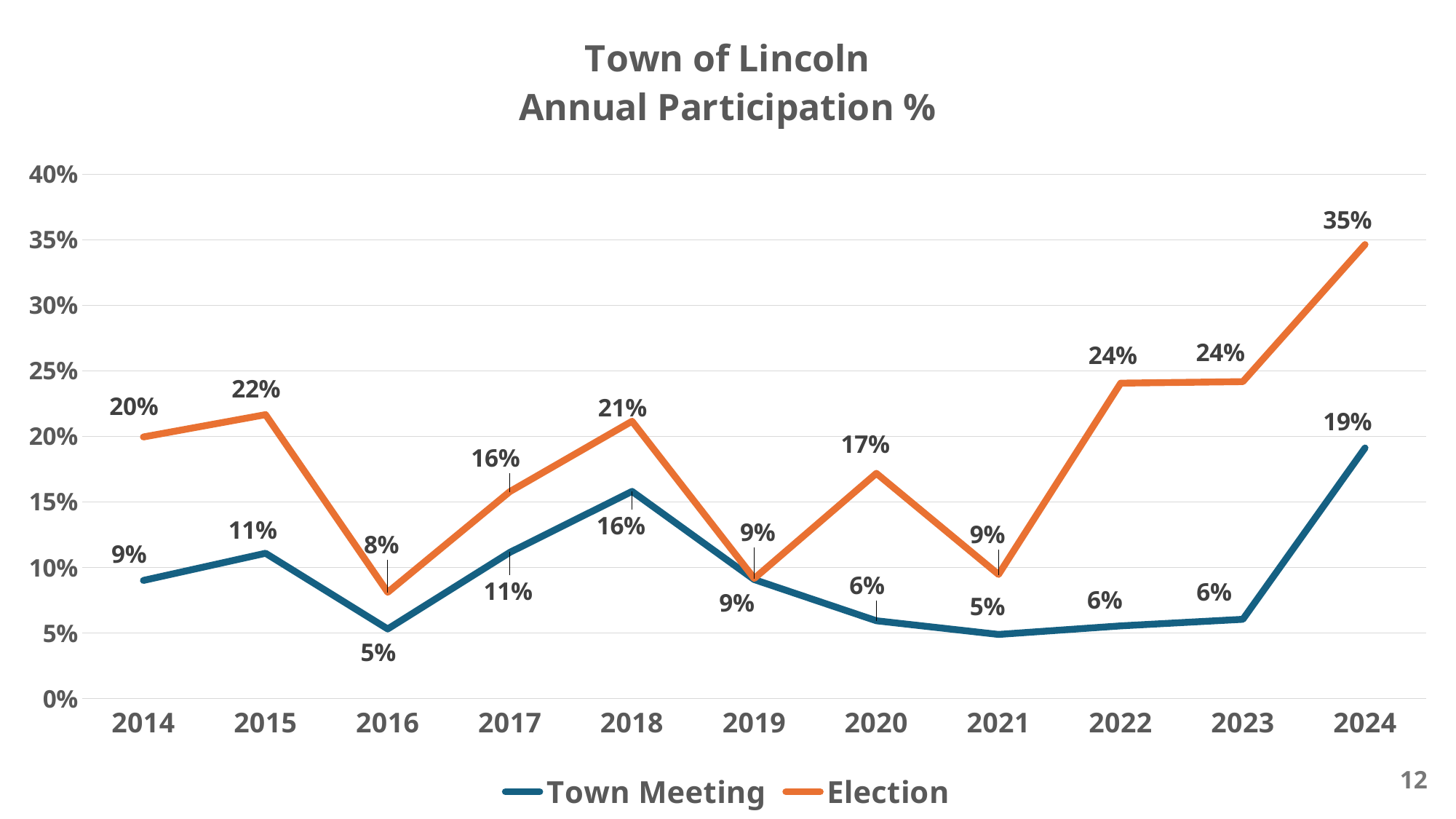
How many years are shown on the x axis? 11 What is the Election participation percentage for 2016? 8% What kind of chart is shown on the slide? Line chart Is the Election participation percentage for 2023 greater or less than 20%? greater What is the title of the chart? Town of Lincoln Annual Participation % How many series does the legend list? 2 What is the Town Meeting participation percentage for 2018? 16% Which year has the highest Election participation percentage? 2024 What is the Election participation percentage for 2024? 35% What is the difference between the Election and Town Meeting participation percentages in 2022? 18% Which is larger in 2020, the Election or the Town Meeting participation percentage? Election